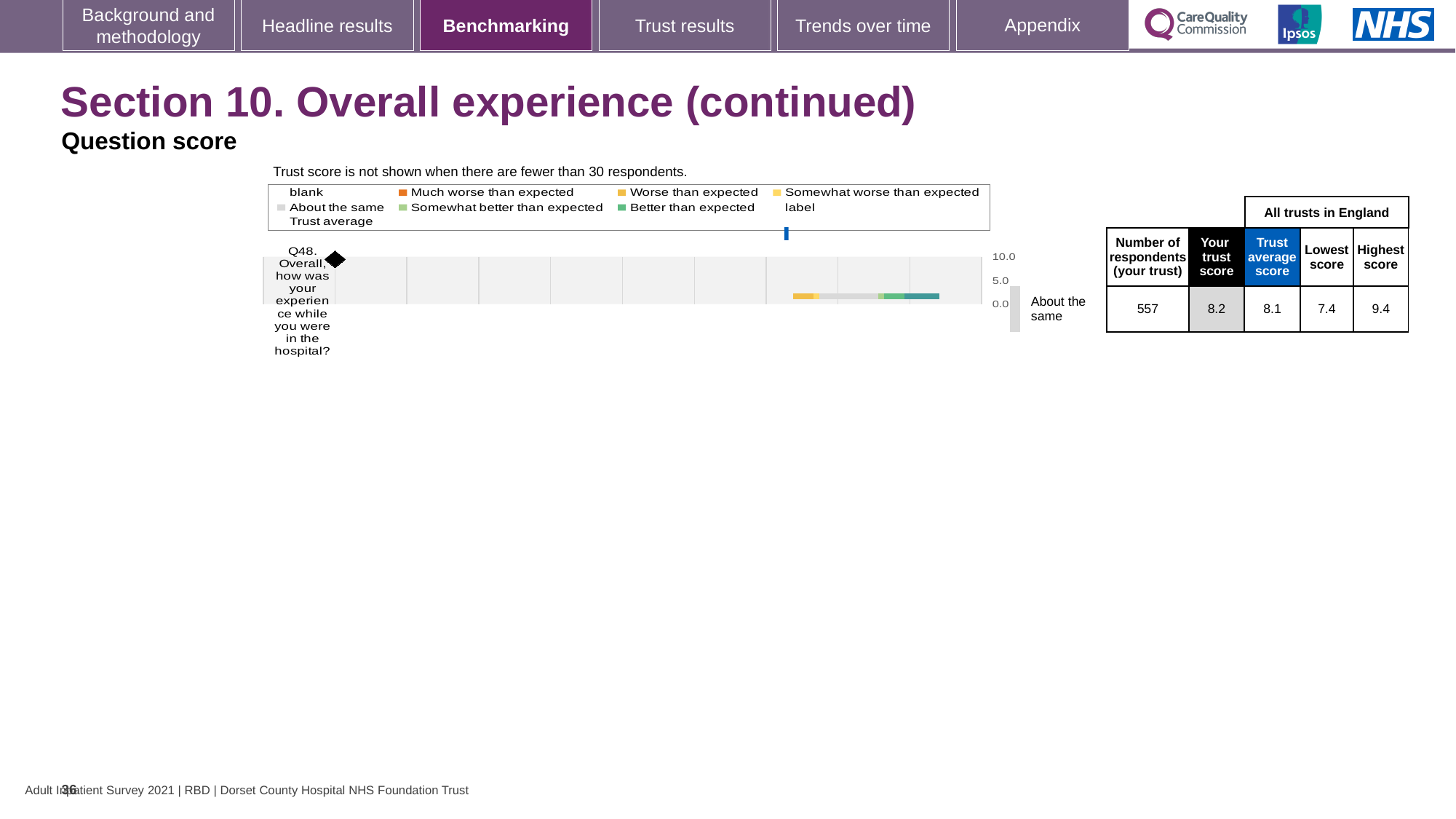
What is the highest value shown on the chart's axis? 10.0 Which question is plotted in the benchmarking chart? Q48. Overall, how was your experience while you were in the hospital? What is the trust's score for Q48 shown in the table? 8.2 What is the lowest score for Q48 among all trusts in England? 7.4 What kind of chart is used to show the Q48 benchmarking result? bar chart What is the difference between the highest and lowest scores for Q48 among all trusts in England? 2.0 How many questions are plotted in the benchmarking chart? 1 What is the highest score for Q48 among all trusts in England? 9.4 What is the trust average score for Q48 across all trusts in England? 8.1 What benchmark category is shown next to the chart for Q48? About the same Which is larger for Q48, the trust's score or the trust average score? the trust's score How many respondents from the trust answered Q48? 557